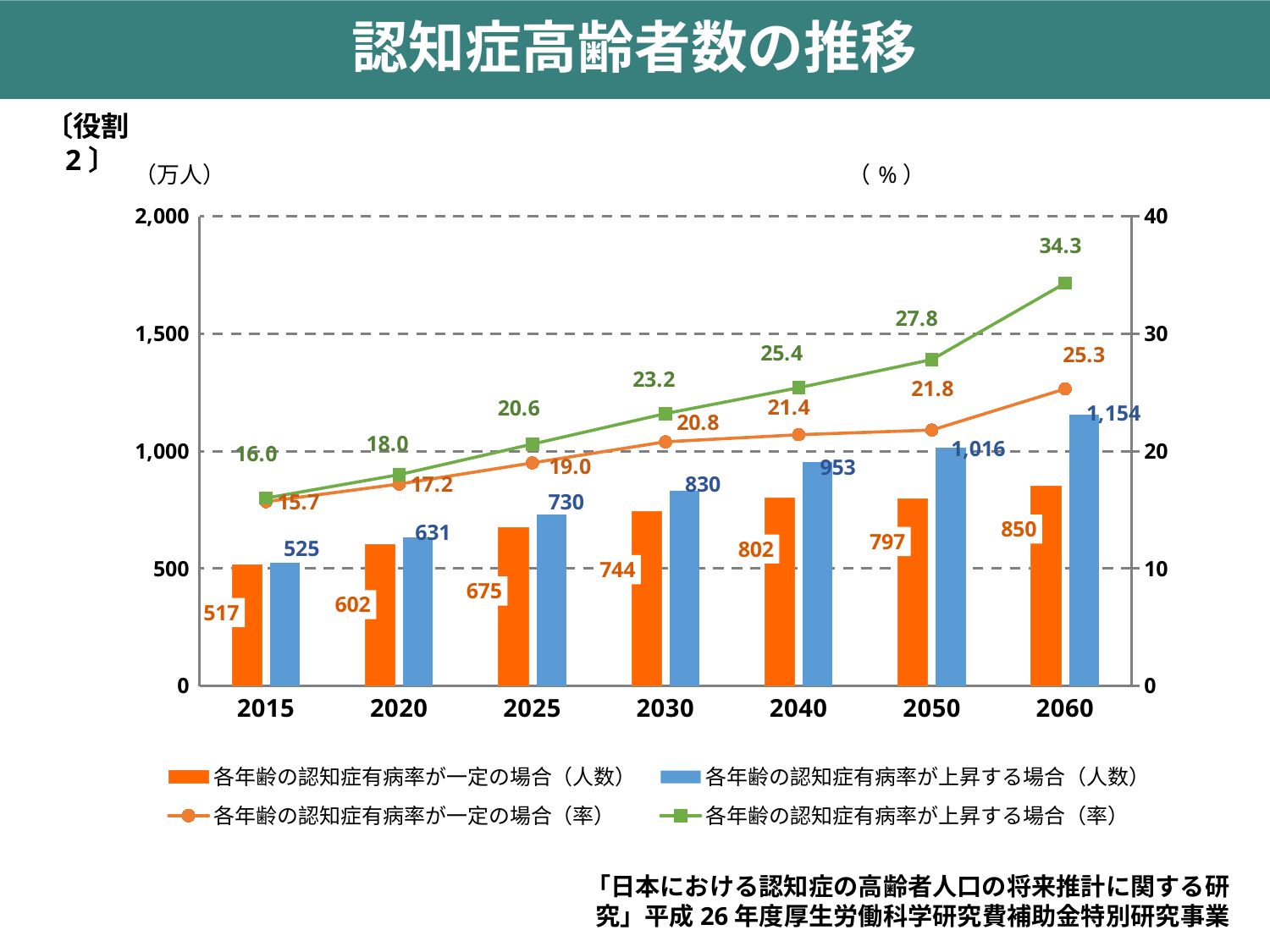
In which year is the 各年齢の認知症有病率が上昇する場合（人数） bar highest? 2060 What is the value of the 各年齢の認知症有病率が上昇する場合（人数） bar for 2060? 1,154 What is the title of the chart? 認知症高齢者数の推移 In which year is the 各年齢の認知症有病率が一定の場合（人数） bar lowest? 2015 What is the value of the 各年齢の認知症有病率が一定の場合（率） line for 2025? 19.0 Which is larger in 2060: the 各年齢の認知症有病率が上昇する場合（率） value or the 各年齢の認知症有病率が一定の場合（率） value? 各年齢の認知症有病率が上昇する場合（率） How many series does the legend list? 4 Does the 各年齢の認知症有病率が上昇する場合（率） line rise or fall from 2015 to 2060? rise How many years are shown on the x axis? 7 What is the difference between the 各年齢の認知症有病率が上昇する場合（人数） bar and the 各年齢の認知症有病率が一定の場合（人数） bar in 2050? 219 What is the value of the 各年齢の認知症有病率が上昇する場合（率） line for 2040? 25.4 What is the value of the 各年齢の認知症有病率が一定の場合（人数） bar for 2015? 517